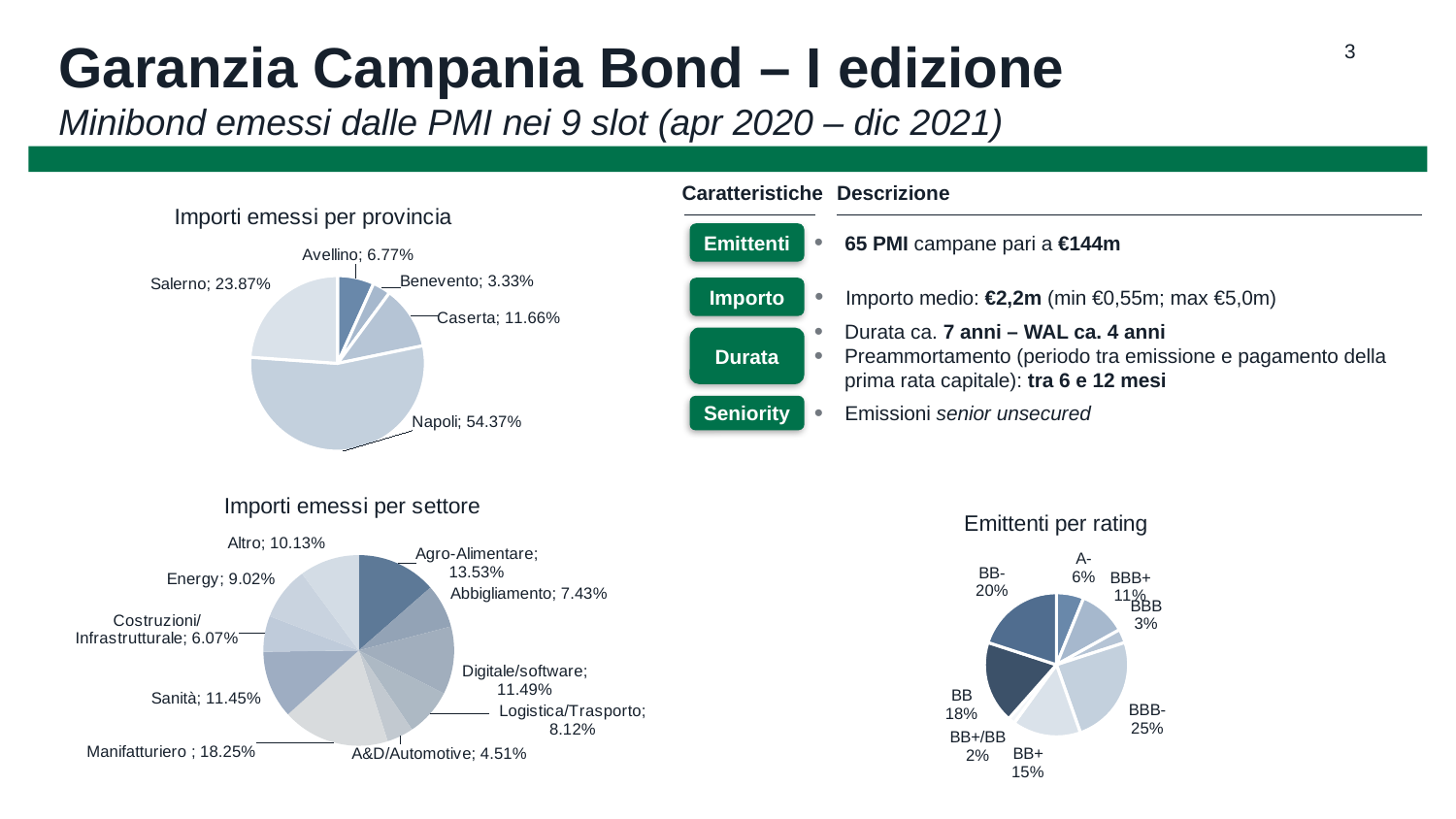
How many provinces are shown in the 'Importi emessi per provincia' chart? 5 In the 'Importi emessi per settore' chart, which sector has the largest share? Manifatturiero In the 'Emittenti per rating' chart, what is the difference between the BB- and BB shares? 2% In the 'Emittenti per rating' chart, which rating category has the smallest share? BB+/BB In the 'Emittenti per rating' chart, what share of issuers has a BBB- rating? 25% In the 'Importi emessi per provincia' chart, what share is shown for Napoli? 54.37% In the 'Importi emessi per provincia' chart, what is the difference between the shares of Salerno and Caserta? 12.21% In the 'Importi emessi per settore' chart, which is larger: Energy or Abbigliamento? Energy In the 'Importi emessi per settore' chart, what share is shown for Sanità? 11.45% In the 'Importi emessi per provincia' chart, which province has the smallest share? Benevento How many sectors are shown in the 'Importi emessi per settore' chart? 10 What type of chart is 'Importi emessi per settore'? Pie chart